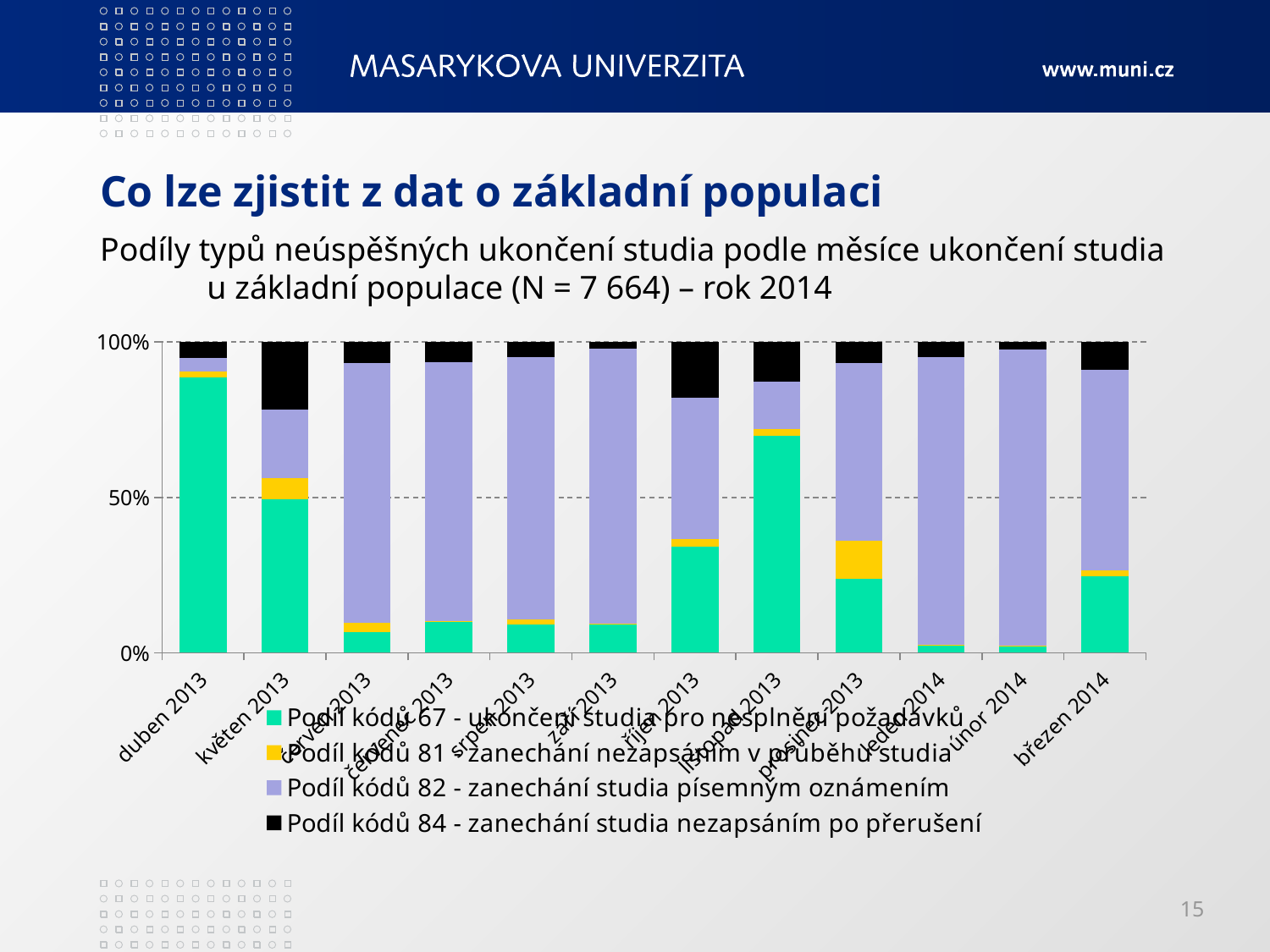
How many series does the legend list? 4 Which month has the largest share of 'Podíl kódů 67 - ukončení studia pro nesplnění požadavků'? duben 2013 Which has a larger share of 'Podíl kódů 67': duben 2013 or listopad 2013? duben 2013 Is the share of 'Podíl kódů 67' for červen 2013 greater or less than 50%? less Which month has the largest share of 'Podíl kódů 84 - zanechání studia nezapsáním po přerušení'? květen 2013 What kind of chart is shown on the slide? stacked bar chart Is the share of 'Podíl kódů 67' for duben 2013 greater or less than 50%? greater What is the first month shown on the x axis? duben 2013 How many months (categories) are plotted along the x axis? 12 Is the share of 'Podíl kódů 67' for listopad 2013 greater or less than 50%? greater Which has a larger share of 'Podíl kódů 82': únor 2014 or květen 2013? únor 2014 What colour represents 'Podíl kódů 84 - zanechání studia nezapsáním po přerušení' in the legend? black